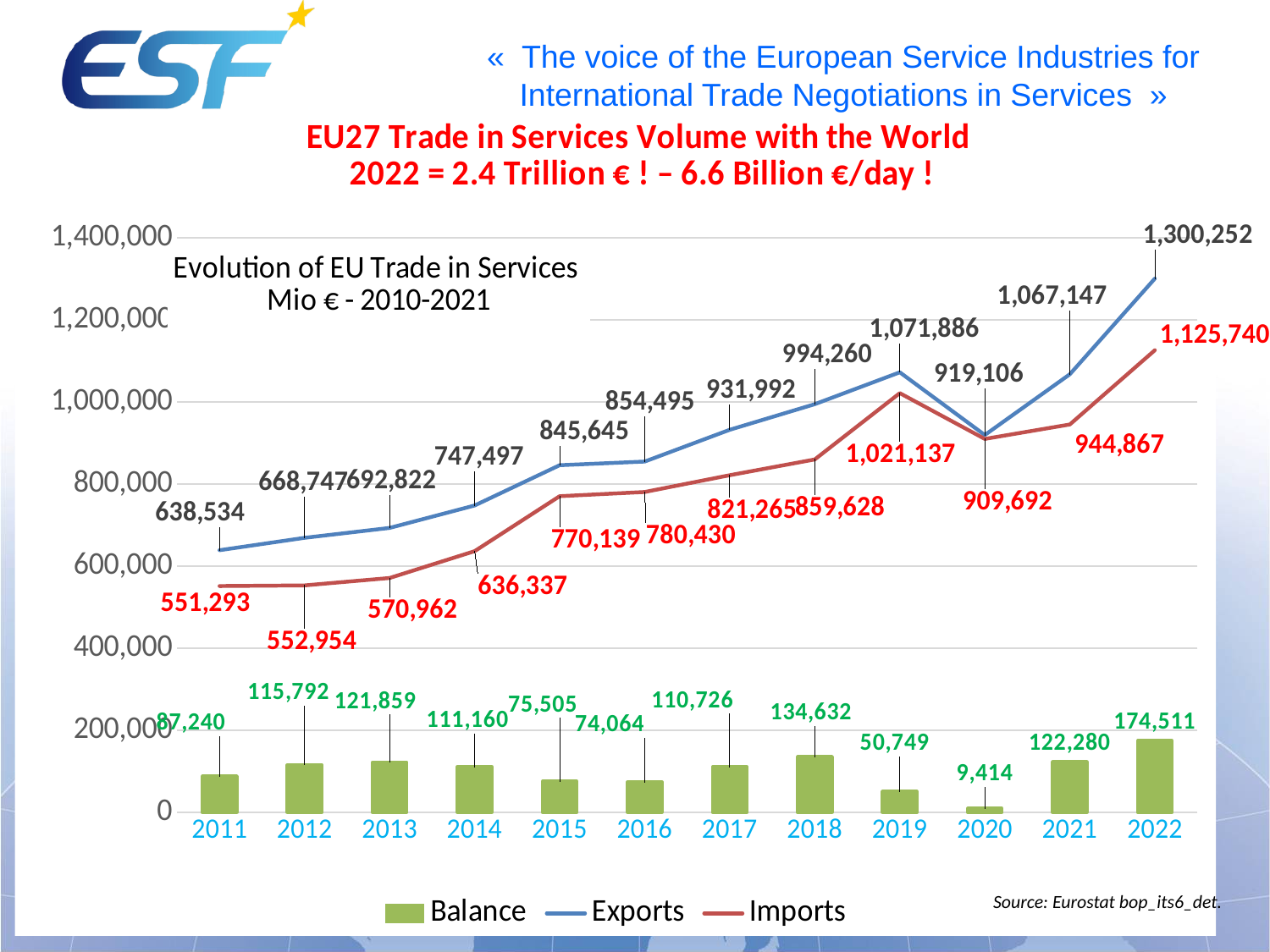
Do the Imports values rise or fall from 2011 to 2019? rise How many series does the legend list? 3 What is the Balance value for 2020? 9,414 Is the Exports value for 2018 greater or less than 1,000,000? less What is the difference between the Exports values for 2022 and 2021? 233,105 Which is larger, the Imports value for 2019 or the Imports value for 2020? 2019 What kind of chart is used to show the Balance series? bar chart What is the Imports value for 2019? 1,021,137 What is the Exports value for 2022? 1,300,252 How many years are shown on the x axis? 12 In which year is the Balance highest? 2022 In which year is the Balance lowest? 2020